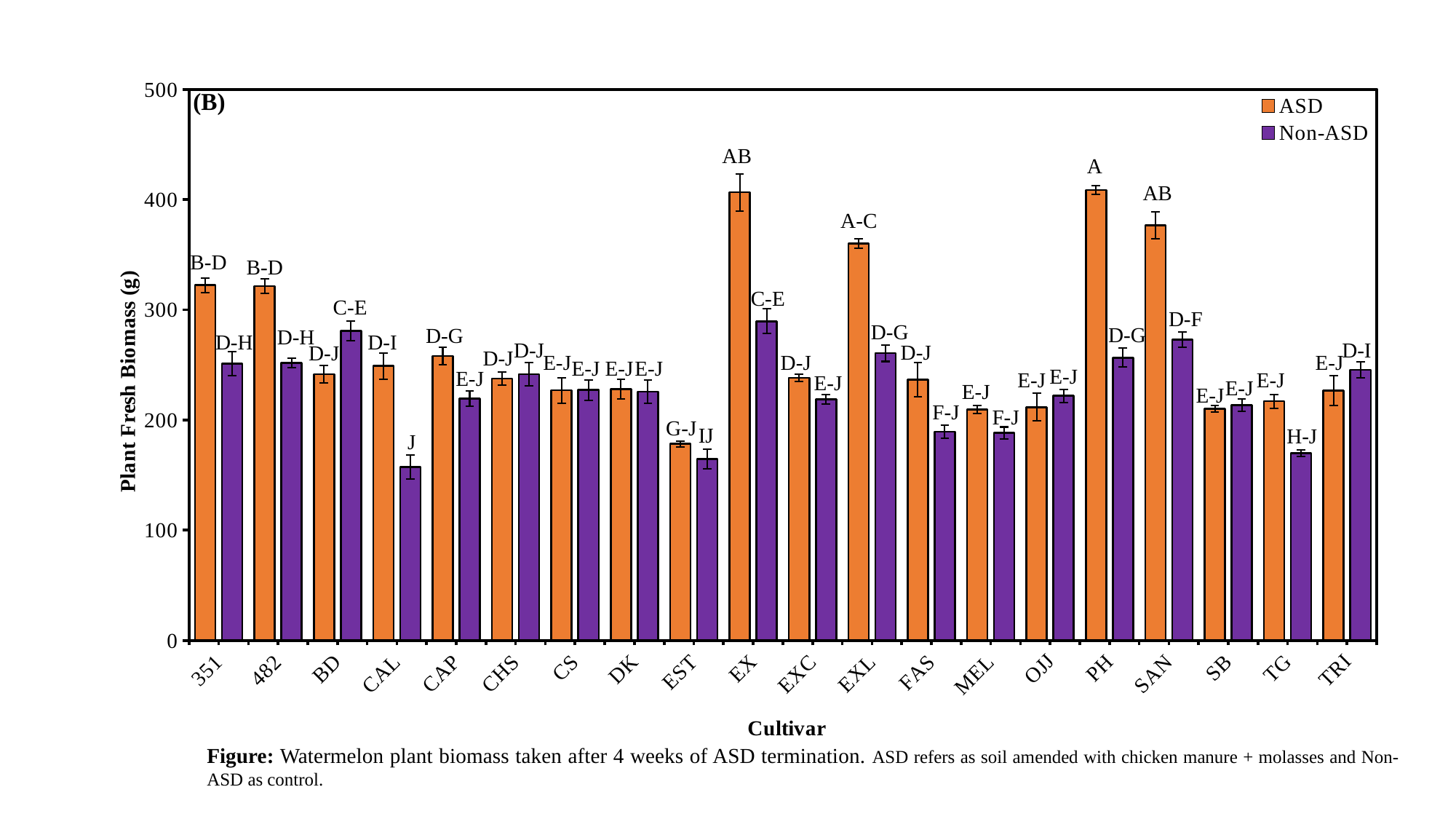
Which cultivar has the lowest ASD plant fresh biomass? EST How many cultivars are shown along the x axis? 20 Which cultivar has the lowest Non-ASD plant fresh biomass? CAL How many series does the legend list? 2 What kind of chart is shown on the slide? bar chart For cultivar BD, which is larger, the ASD or the Non-ASD value? Non-ASD For cultivar CAL, which is larger, the ASD or the Non-ASD value? ASD Is the ASD value for EXL greater or less than 300? greater Is the Non-ASD value for TG greater or less than 200? less What is the label of the y axis? Plant Fresh Biomass (g) Is the ASD value for SAN greater or less than 300? greater Which colour represents the Non-ASD series? purple